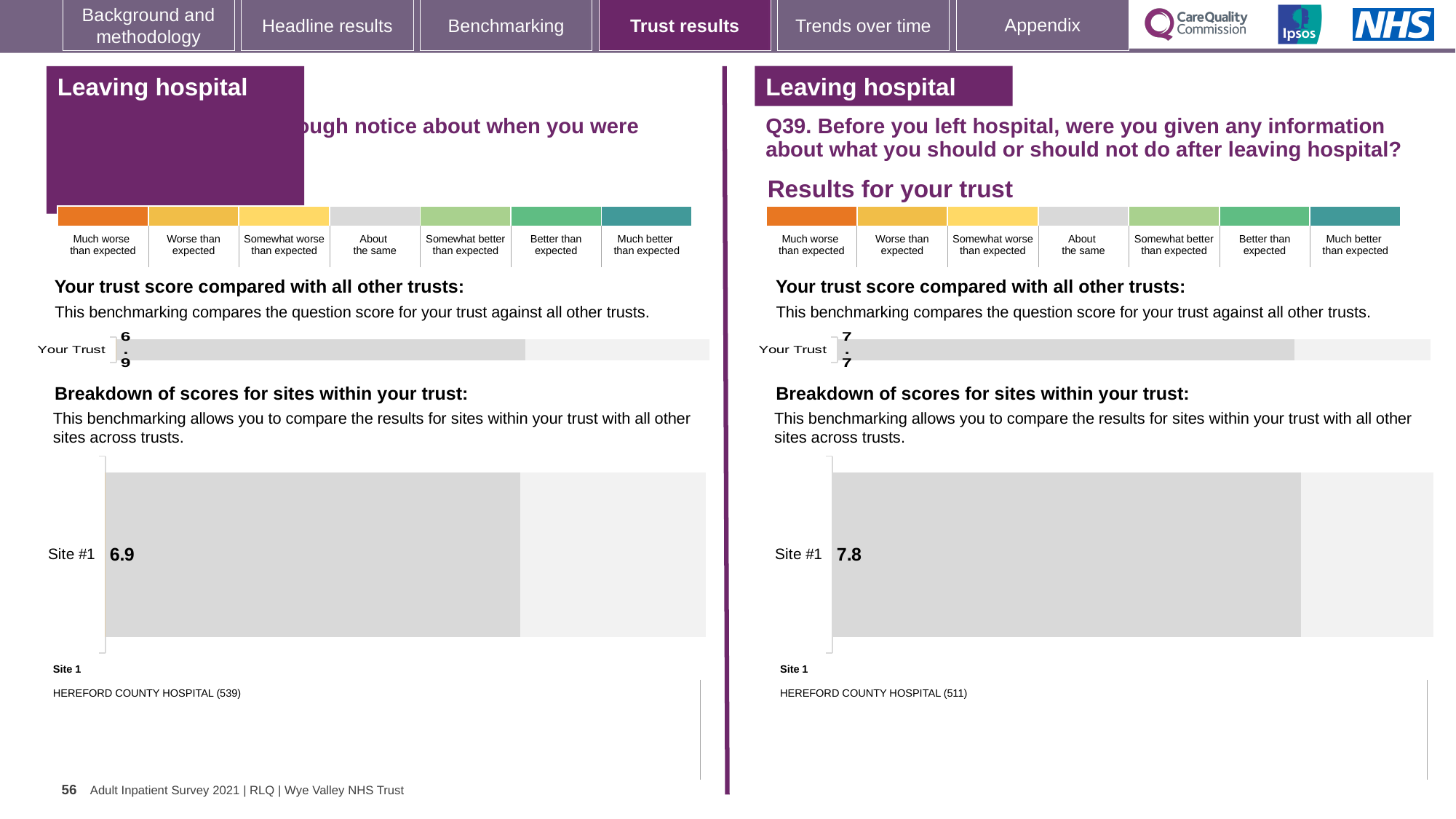
On the left half of the slide, what is the score shown for Your Trust in the 'Your trust score compared with all other trusts' chart? 6.9 On the left half of the slide, what score is shown for Site #1 in the breakdown of scores for sites within your trust? 6.9 On the right half of the slide (Q39), which hospital is listed as Site 1 below the breakdown chart? HEREFORD COUNTY HOSPITAL (511) How many sites are shown in the breakdown of scores chart on the left half of the slide? 1 On the left half of the slide, which hospital is listed as Site 1 below the breakdown chart? HEREFORD COUNTY HOSPITAL (539) On the right half of the slide (Q39), what is the score shown for Your Trust in the 'Your trust score compared with all other trusts' chart? 7.7 What is the difference between the Site #1 score on the right half (Q39) and the Site #1 score on the left half of the slide? 0.9 How many sites are shown in the breakdown of scores chart on the right half of the slide (Q39)? 1 Which is larger: the Site #1 score on the left half of the slide or the Site #1 score on the right half (Q39)? Right half (Q39), 7.8 What type of chart is used to show the Site #1 score on the right half of the slide (Q39)? Bar chart On the right half of the slide (Q39), what score is shown for Site #1 in the breakdown of scores for sites within your trust? 7.8 On the right half of the slide (Q39), what is the difference between the Site #1 score and the Your Trust score? 0.1